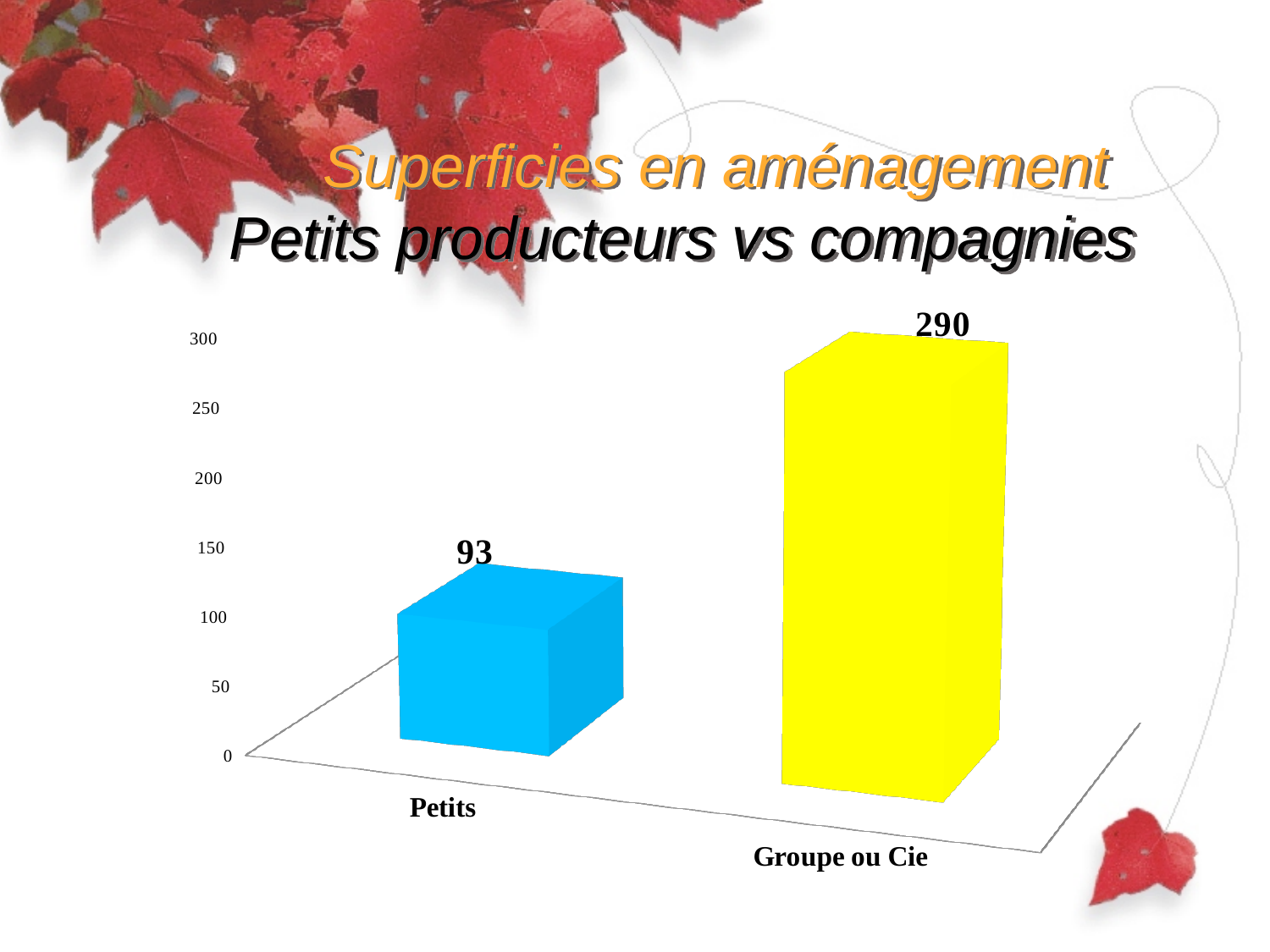
What is the total of the two values shown in the chart? 383 What kind of chart is shown on the slide? bar chart What is the value for Groupe ou Cie? 290 What is the difference between the values for Groupe ou Cie and Petits? 197 Is the value for Petits greater or less than 100? less Is the value for Groupe ou Cie greater or less than 250? greater Which category has the highest value? Groupe ou Cie Which is larger, the value for Petits or the value for Groupe ou Cie? Groupe ou Cie How many categories are shown in the chart? 2 What is the value for Petits? 93 What colour is the bar for Groupe ou Cie? yellow Which category has the lowest value? Petits